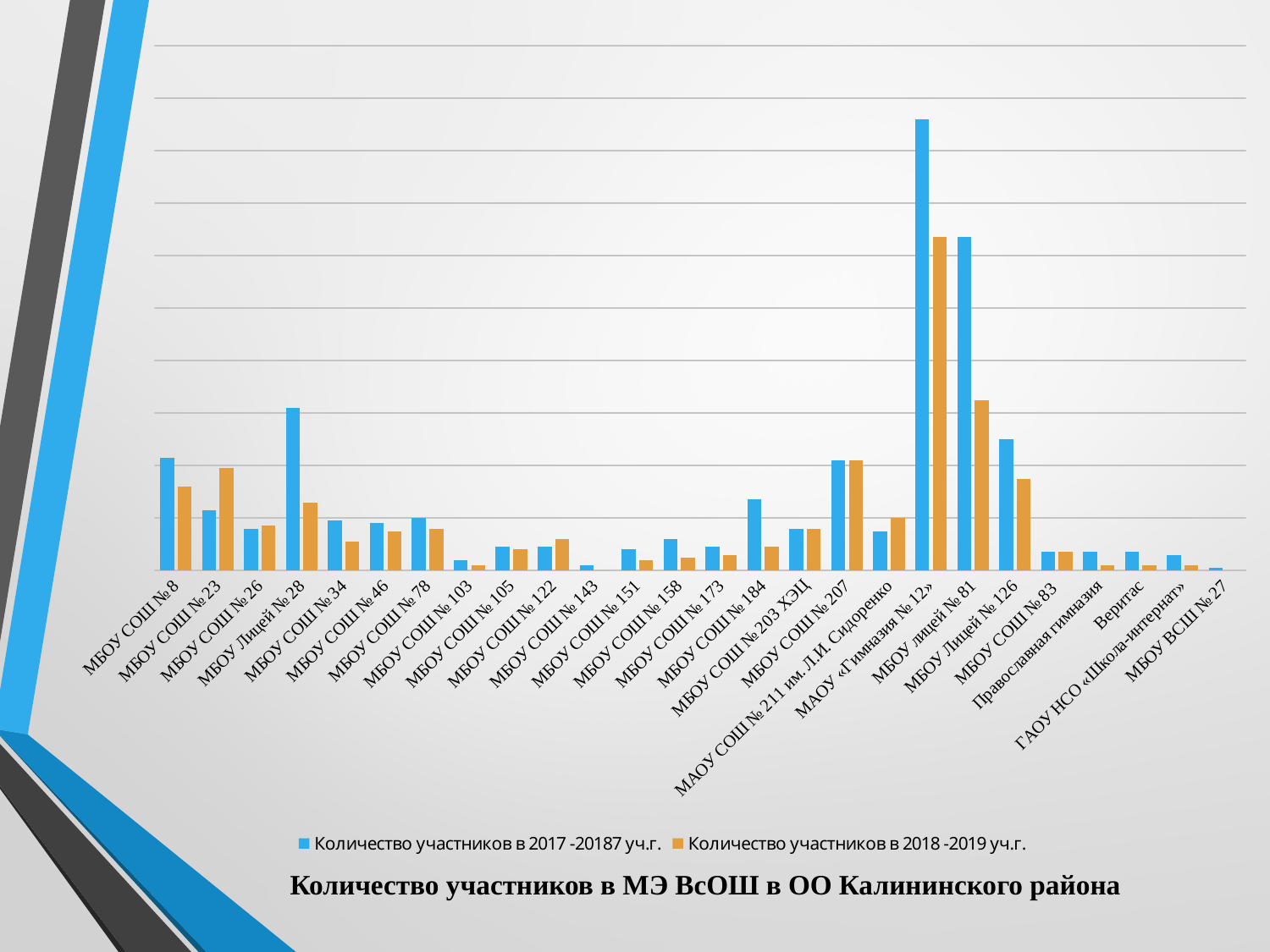
For МБОУ Лицей № 126, which year has more participants, 2017-2018 or 2018-2019? 2017-2018 For МАОУ СОШ № 211 им. Л.И. Сидоренко, which year has more participants, 2017-2018 or 2018-2019? 2018-2019 Which series is shown in blue? Количество участников в 2017 -20187 уч.г. Which school has the highest number of participants in 2017-2018? МАОУ «Гимназия № 12» How many series does the legend list? 2 What is the title of the chart? Количество участников в МЭ ВсОШ в ОО Калининского района Which school has the highest number of participants in 2018-2019? МАОУ «Гимназия № 12» For МБОУ СОШ № 23, which year has more participants, 2017-2018 or 2018-2019? 2018-2019 What kind of chart is shown on the slide? bar chart How many schools (categories) are shown on the x axis? 26